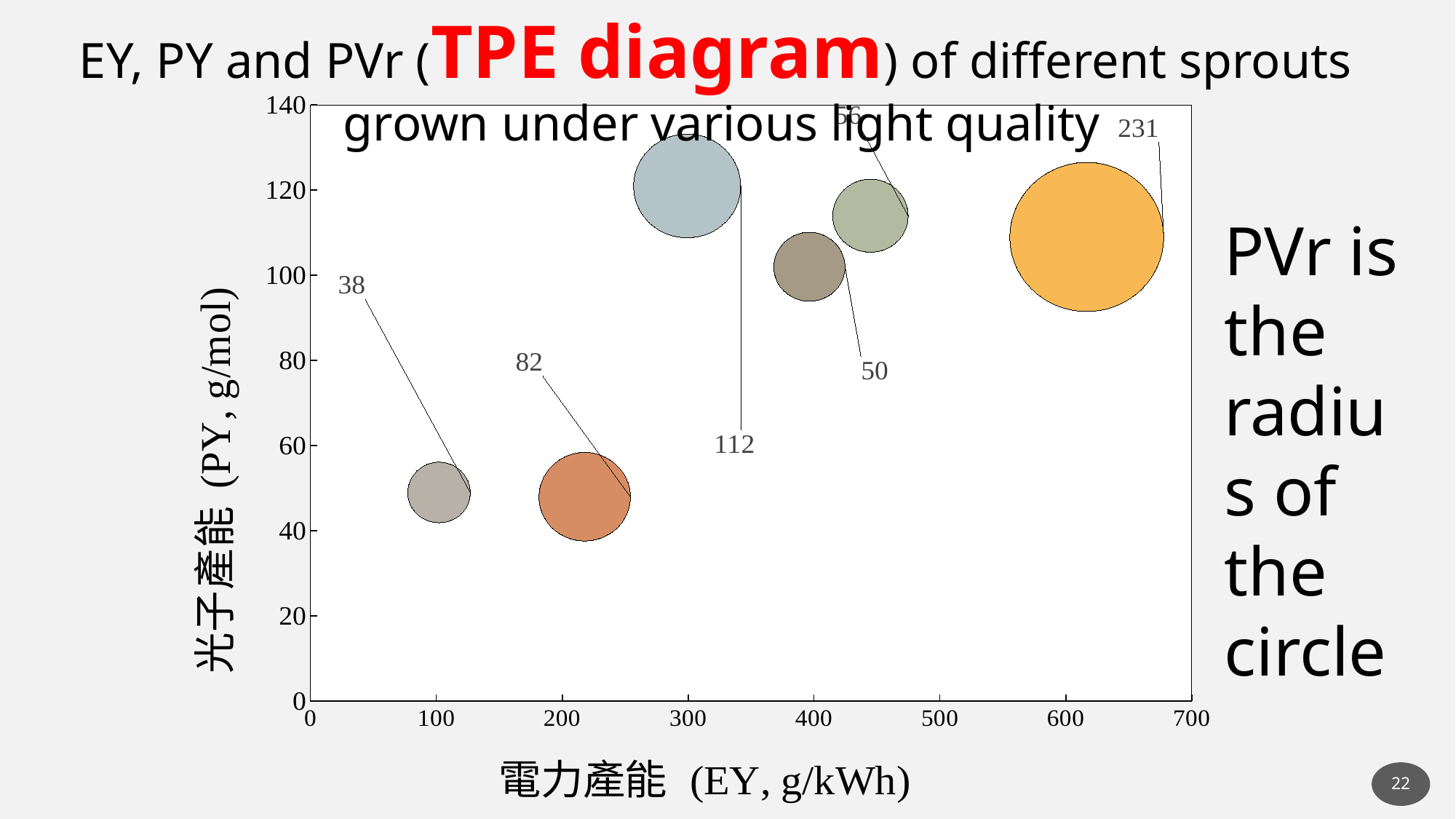
Is the PY value of the bubble labelled 112 greater or less than 100? greater What kind of chart is shown on the slide? bubble chart Is the EY value of the bubble labelled 231 greater or less than 500? greater Is the EY value of the bubble labelled 82 greater or less than 300? less What is the smallest PVr value labelled on a bubble in the chart? 38 How many bubbles are plotted in the chart? 6 What is the largest PVr value labelled on a bubble in the chart? 231 Which bubble has the larger PVr label, the one labelled 82 or the one labelled 56? 82 According to the slide, what does the radius of each circle represent? PVr What is the difference between the largest and smallest PVr labels shown (231 and 38)? 193 What is the label of the x axis of the chart? 電力產能 (EY, g/kWh)